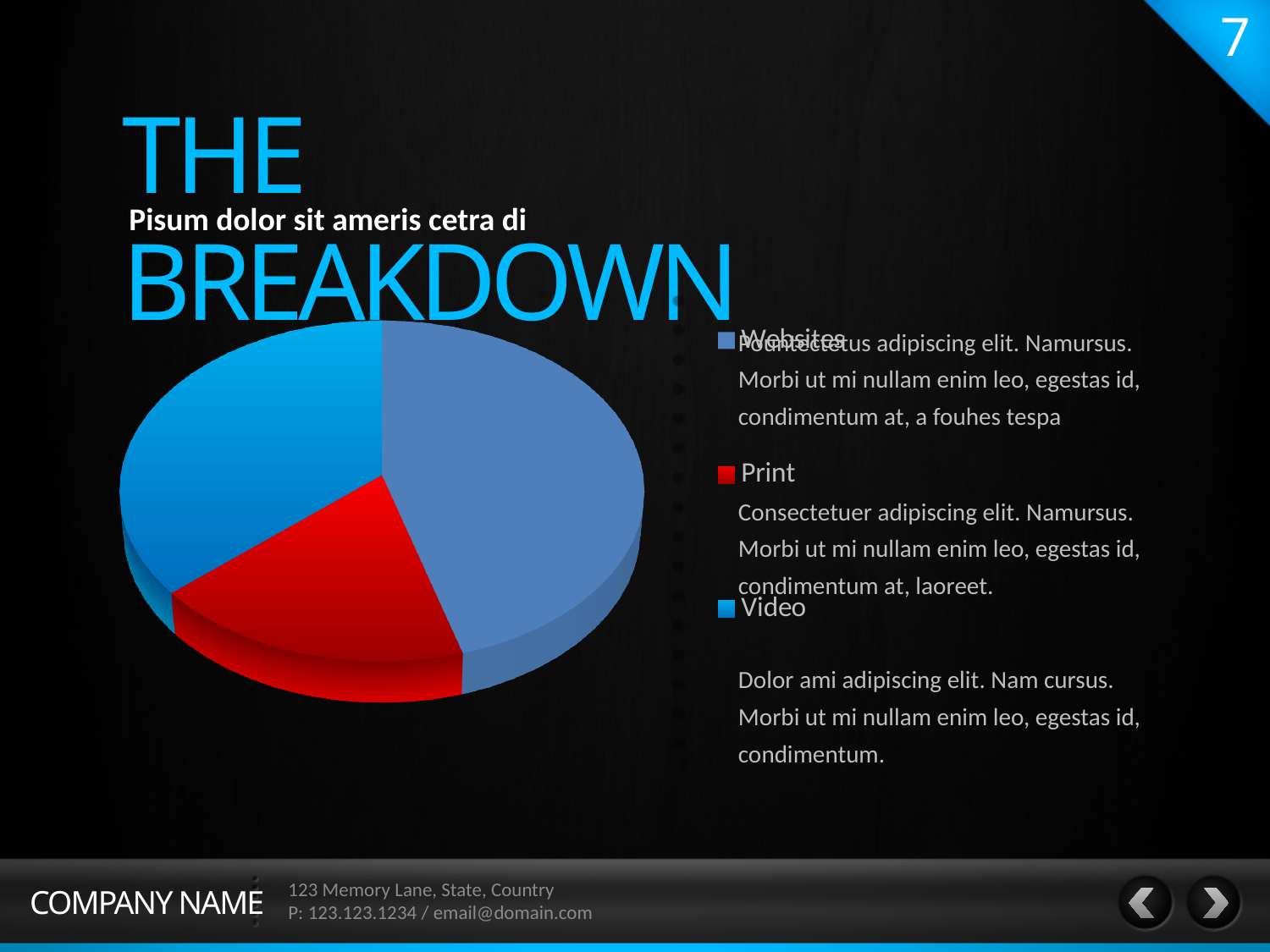
What are the three categories listed in the chart legend? Websites, Print, Video Which category has the largest slice of the pie chart? Websites Which slice is larger, Websites or Video? Websites What colour is the Print slice in the pie chart? red How many slices does the pie chart have? 3 Which category has the smallest slice of the pie chart? Print How many entries does the chart legend list? 3 What kind of chart is shown on the slide? pie chart Which slice is larger, Print or Video? Video Which slice is larger, Websites or Print? Websites